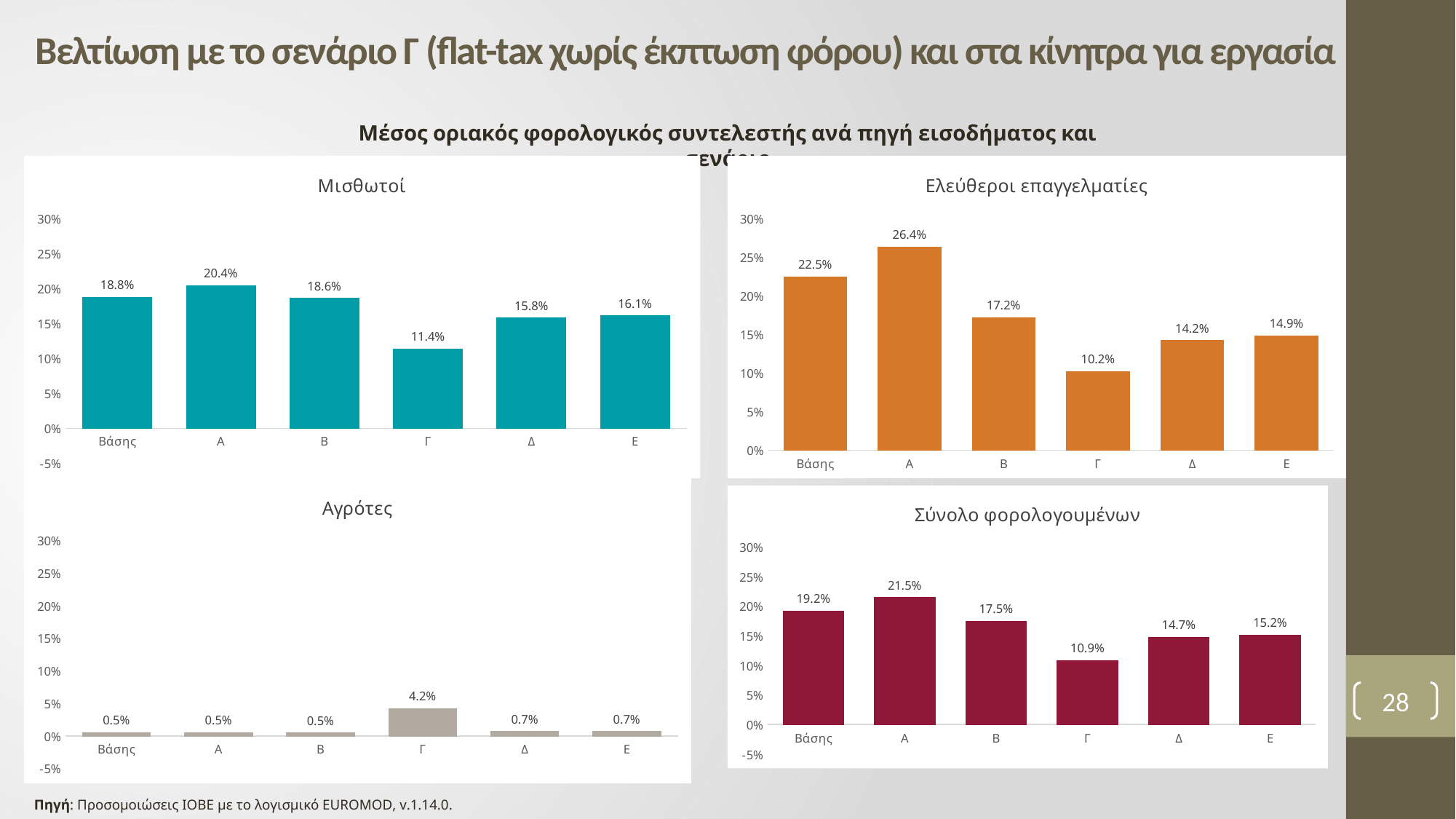
What is the title of the chart in the bottom-left of the slide? Αγρότες In the 'Ελεύθεροι επαγγελματίες' chart, which category has the highest value? Α What type of chart is the 'Ελεύθεροι επαγγελματίες' chart? bar chart How many categories are shown on the x axis of the 'Αγρότες' chart? 6 In the 'Αγρότες' chart, what is the value for scenario Γ? 4.2% In the 'Σύνολο φορολογουμένων' chart, which category has the lowest value? Γ In the 'Σύνολο φορολογουμένων' chart, is the value for Α greater or less than 20%? greater In the 'Μισθωτοί' chart, what is the value for scenario Γ? 11.4% In the 'Ελεύθεροι επαγγελματίες' chart, what is the difference between the Α value and the Γ value? 16.2% In the 'Σύνολο φορολογουμένων' chart, what is the value for Βάσης? 19.2% In the 'Ελεύθεροι επαγγελματίες' chart, is the value for Δ larger or smaller than the value for Ε? smaller In the 'Μισθωτοί' chart, what is the difference between the Βάσης value and the Γ value? 7.4%